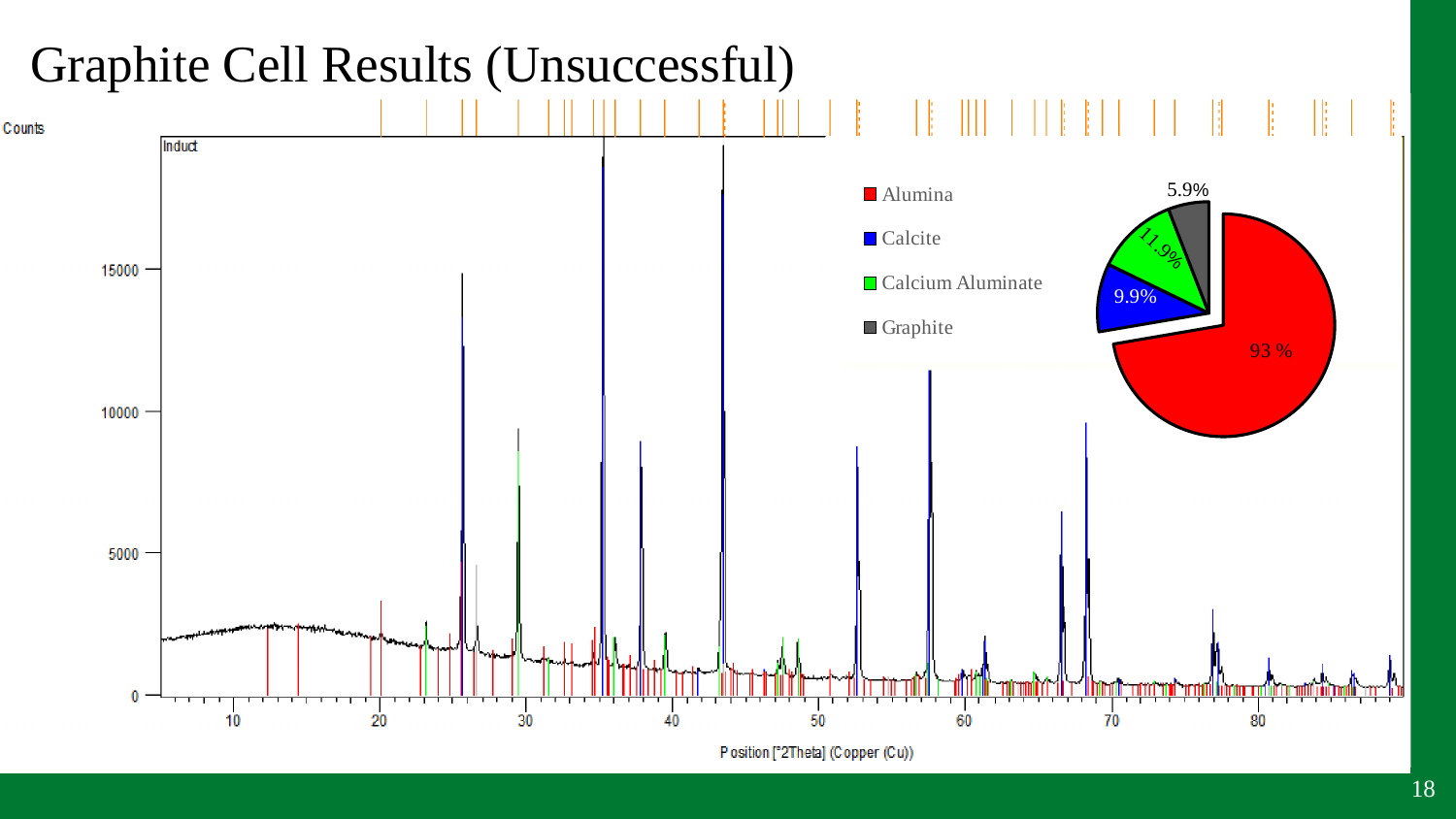
How many entries does the pie chart legend list? 4 In the pie chart, which phase has the largest slice? Alumina In the Counts chart, is the tallest peak near 43 °2Theta greater or less than 15000 counts? greater In the pie chart, which slice is larger, Calcite or Calcium Aluminate? Calcium Aluminate In the pie chart, what percentage is shown for Graphite? 5.9% In the pie chart, what percentage is shown for Calcite? 9.9% In the pie chart, what percentage is shown for Calcium Aluminate? 11.9% What kind of chart is the large chart showing Counts against Position? Line chart In the pie chart, what percentage is shown for Alumina? 93 % In the pie chart, which phase has the smallest slice? Graphite In the pie chart, what colour is the Alumina slice? Red What kind of chart is the chart on the right side of the slide? Pie chart